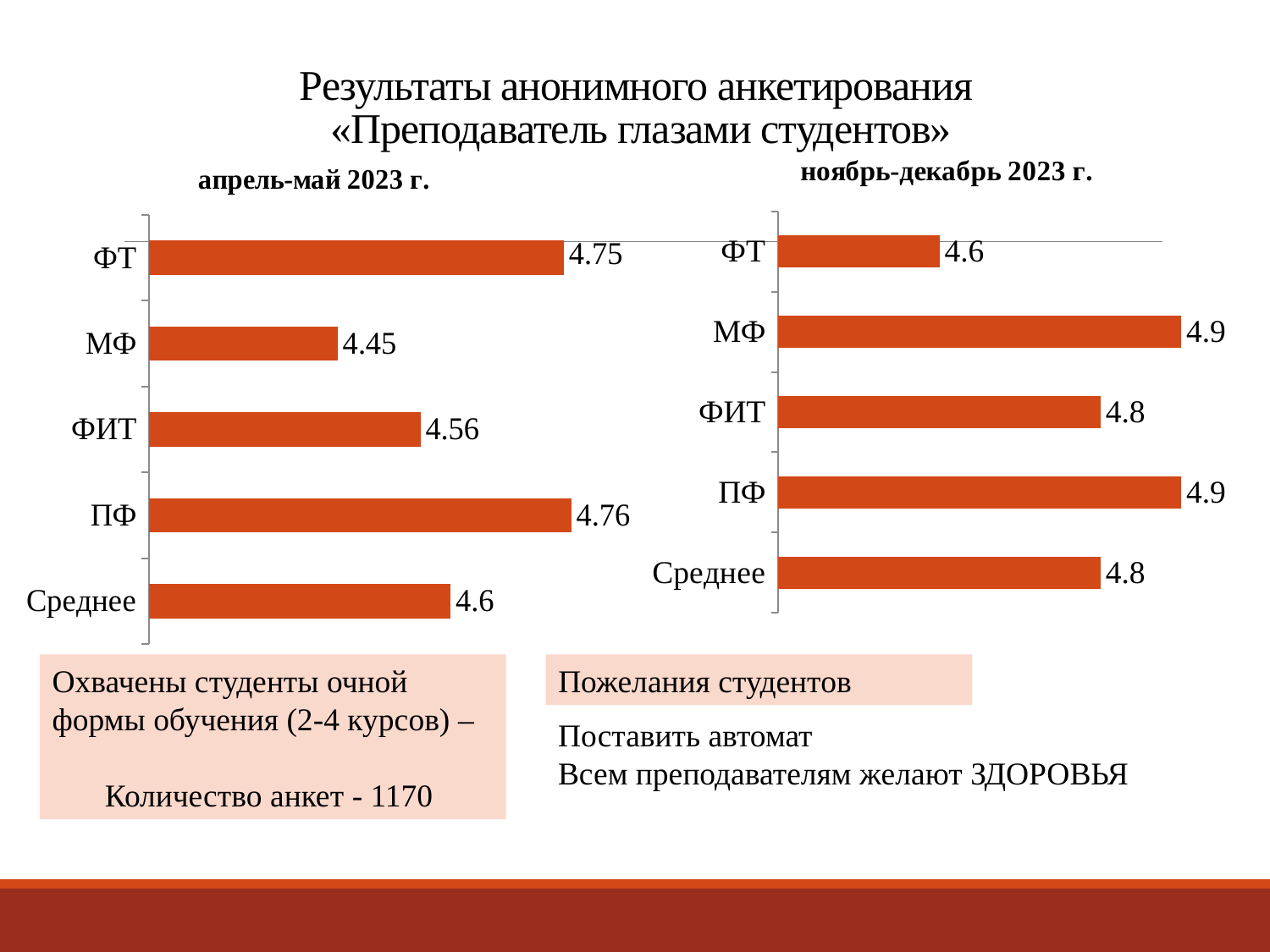
In the chart titled «ноябрь-декабрь 2023 г.», what is the value for ФИТ? 4.8 In the chart titled «ноябрь-декабрь 2023 г.», which category has the lowest value? ФТ In the chart titled «апрель-май 2023 г.», which category has the lowest value? МФ In the chart titled «апрель-май 2023 г.», what is the value for МФ? 4.45 In the chart titled «апрель-май 2023 г.», what is the value for ФТ? 4.75 In the chart titled «апрель-май 2023 г.», which is larger, the value for ФИТ or the value for МФ? ФИТ What type of chart is the chart titled «ноябрь-декабрь 2023 г.»? bar chart In the chart titled «ноябрь-декабрь 2023 г.», which is larger, the value for ПФ or the value for ФТ? ПФ In the chart titled «ноябрь-декабрь 2023 г.», what is the difference between the values for МФ and ФТ? 0.3 In the chart titled «апрель-май 2023 г.», what is the difference between the values for ФТ and МФ? 0.3 How many categories are shown in the chart titled «апрель-май 2023 г.»? 5 In the chart titled «ноябрь-декабрь 2023 г.», what is the value for Среднее? 4.8